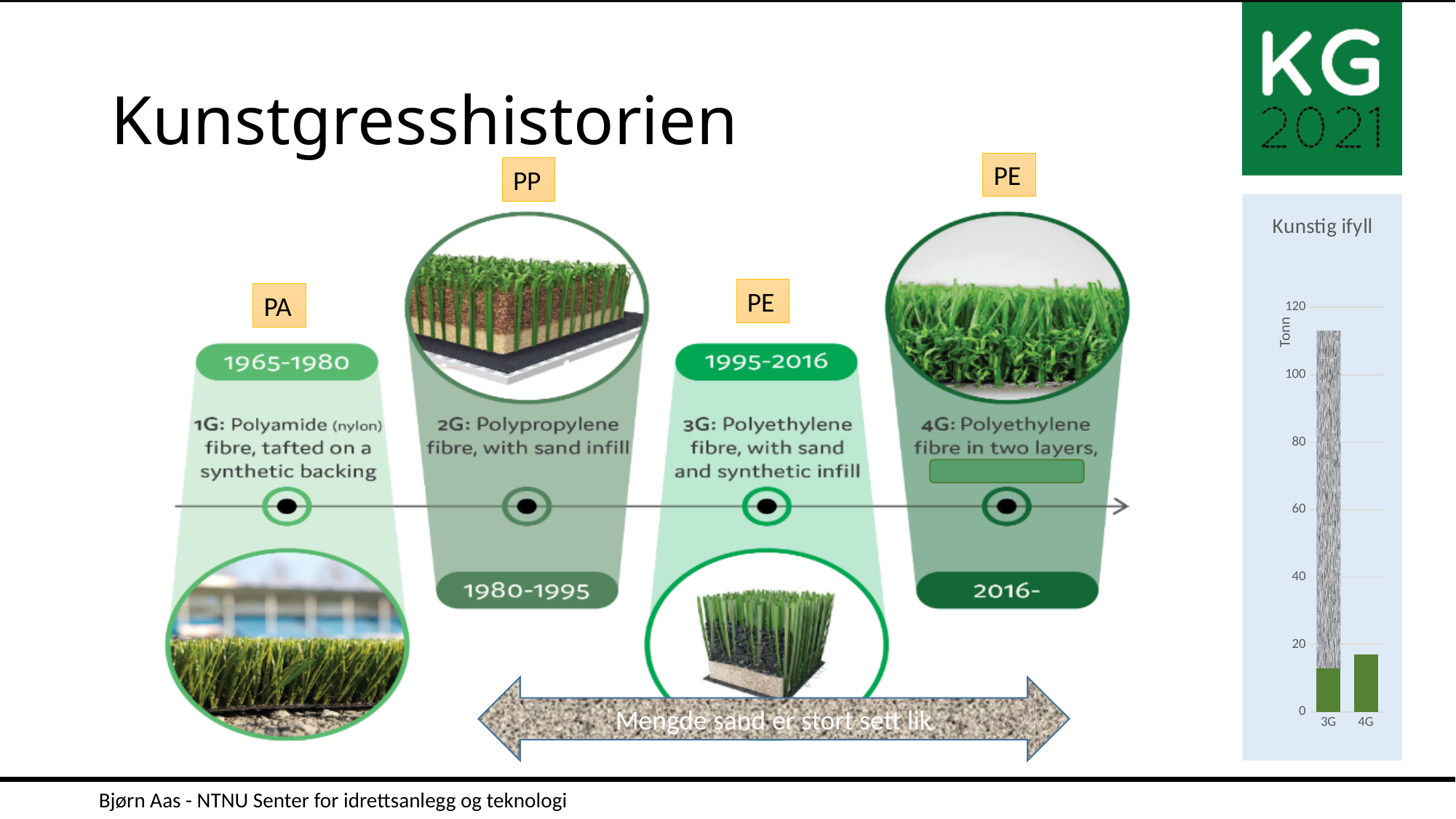
In the 'Kunstig ifyll' chart, is the value for 4G greater or less than 20? less How many categories are shown on the x axis of the 'Kunstig ifyll' chart? 2 In the 'Kunstig ifyll' chart, is the green segment of the 3G bar greater or less than 20? less What is the highest tick value shown on the y axis of the 'Kunstig ifyll' chart? 120 What kind of chart is the 'Kunstig ifyll' chart? bar chart In the 'Kunstig ifyll' chart, which category has the taller bar overall, 3G or 4G? 3G In the 'Kunstig ifyll' chart, is the total height of the 3G bar greater or less than 120? less In the 'Kunstig ifyll' chart, which category has the tallest bar? 3G In the 'Kunstig ifyll' chart, which category has the shortest bar? 4G What is the label of the y axis of the 'Kunstig ifyll' chart? Tonn What is the title of the chart on the right side of the slide? Kunstig ifyll